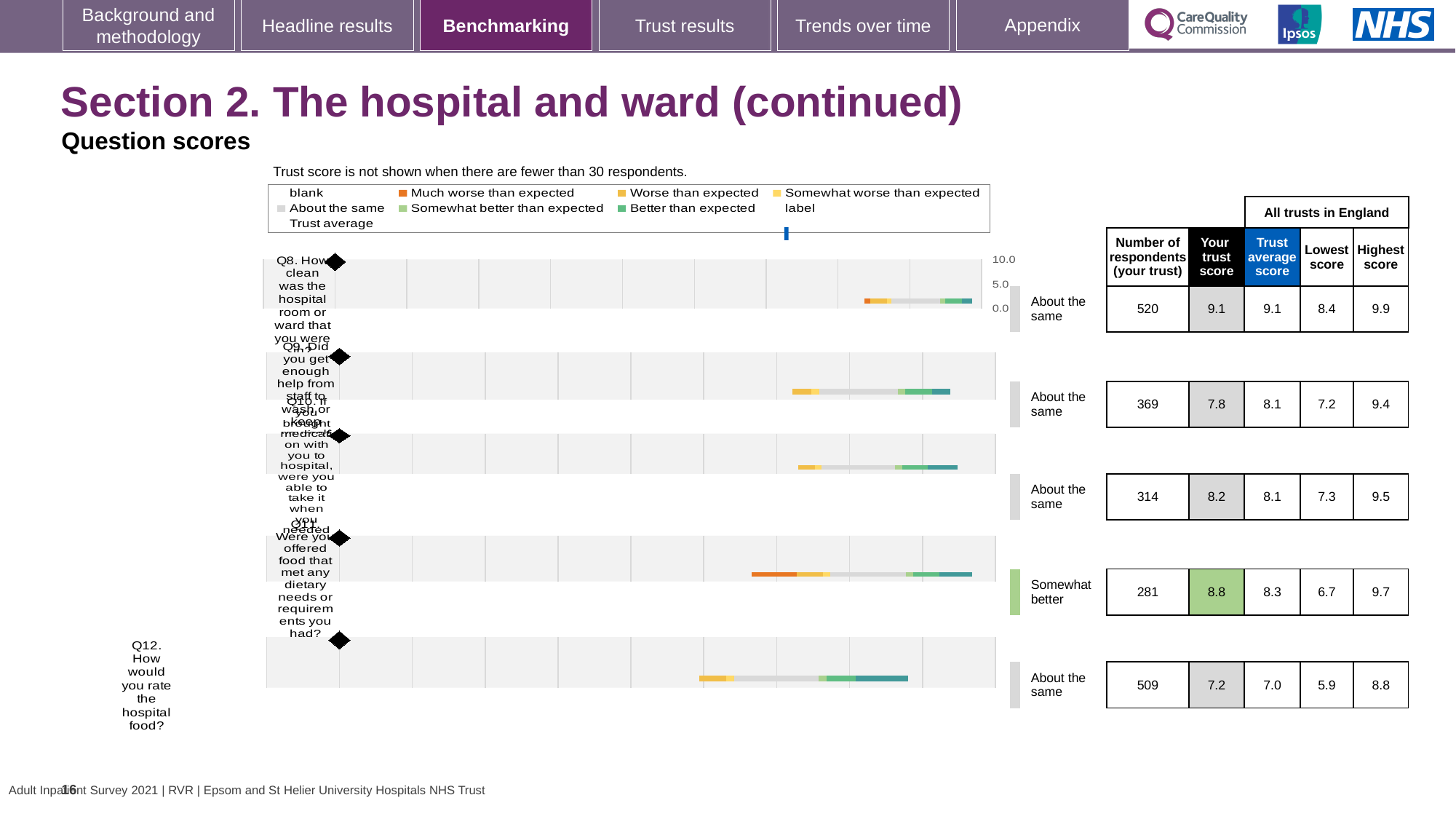
What kind of chart is used to show the question scores on this slide? bar chart Which question has the highest 'Your trust score'? Q8 How many respondents from your trust answered Q11? 281 Which question has the lowest 'Your trust score'? Q12 For Q9, which is larger: 'Your trust score' or the 'Trust average score'? Trust average score What is the 'Your trust score' for Q8 (How clean was the hospital room or ward)? 9.1 Which question is rated 'Somewhat better' rather than 'About the same'? Q11 What is the 'Lowest score' across all trusts in England for Q9? 7.2 For Q11, what is the difference between 'Your trust score' and the 'Trust average score'? 0.5 What is the 'Highest score' across all trusts in England for Q10? 9.5 How many questions (Q8 to Q12) are plotted in the chart? 5 How many respondents from your trust answered Q12 (How would you rate the hospital food)? 509